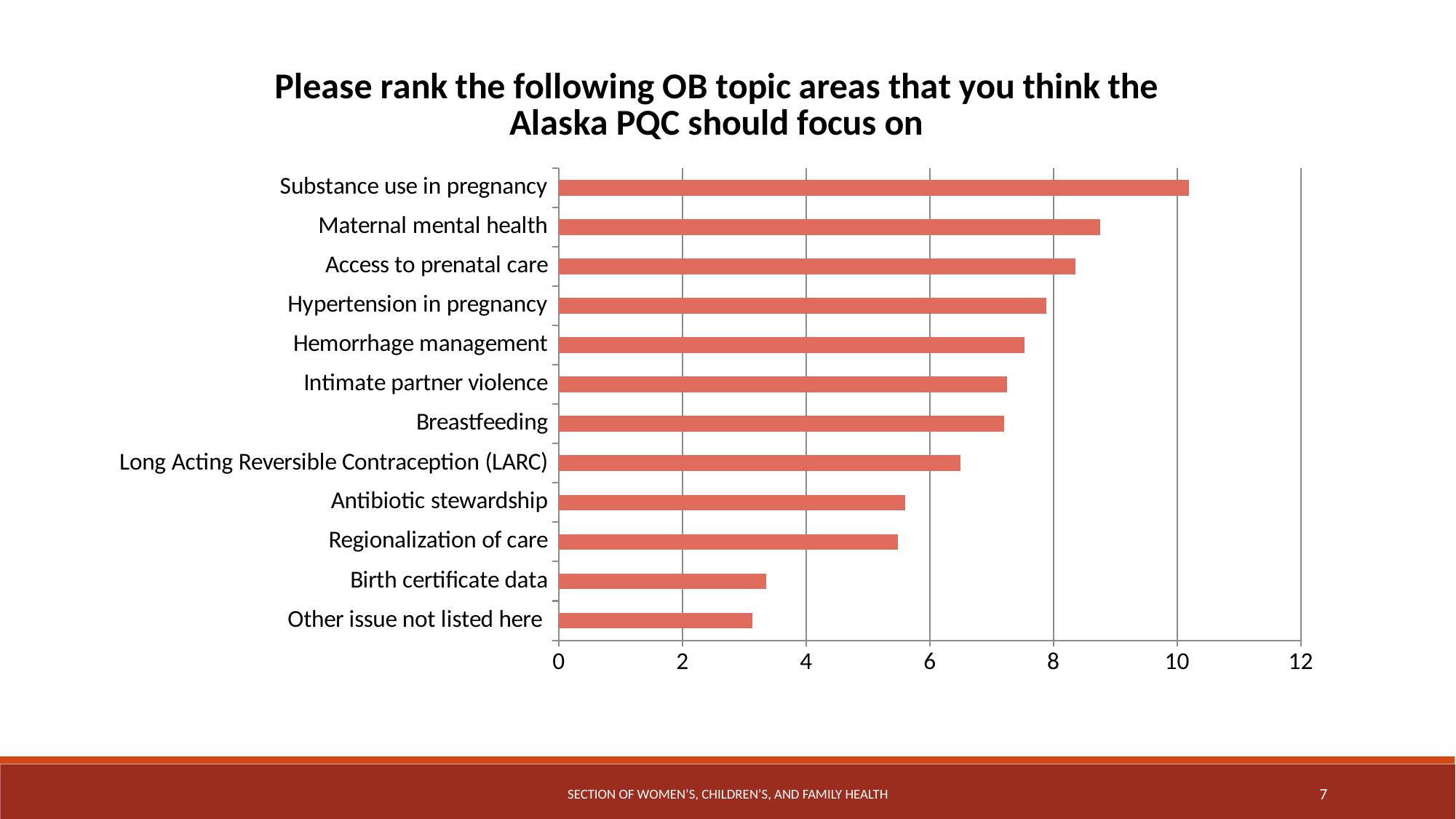
Is the value for Long Acting Reversible Contraception (LARC) greater or less than 6? greater Is the value for Maternal mental health greater or less than 8? greater How many OB topic areas are plotted in the chart? 12 What kind of chart is shown on the slide? bar chart Which topic area has the highest value? Substance use in pregnancy Is the value for Substance use in pregnancy greater or less than 10? greater Which is larger, the value for Access to prenatal care or the value for Breastfeeding? Access to prenatal care What is the title of the chart? Please rank the following OB topic areas that you think the Alaska PQC should focus on Which topic area has the lowest value? Other issue not listed here